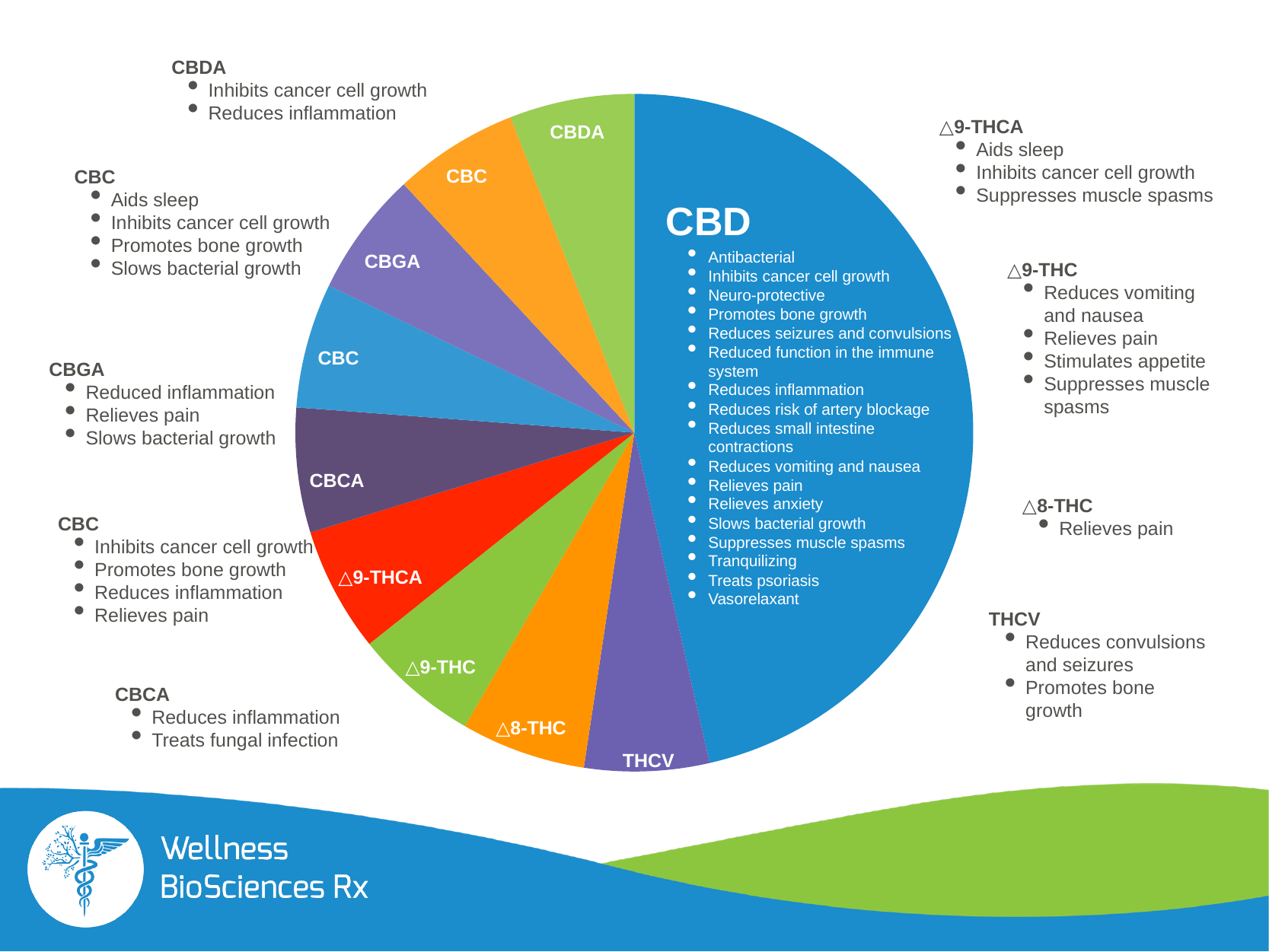
What kind of chart is shown on the slide? pie chart Which slice is larger, CBD or CBCA? CBD Which slice is larger, CBD or THCV? CBD What colour is the △9-THCA slice of the pie chart? red Which slice of the pie chart is the largest? CBD How many slices of the pie chart are labelled CBC? 2 What colour is the CBD slice of the pie chart? blue How many slices does the pie chart have? 10 Which slice is larger, CBD or △9-THCA? CBD